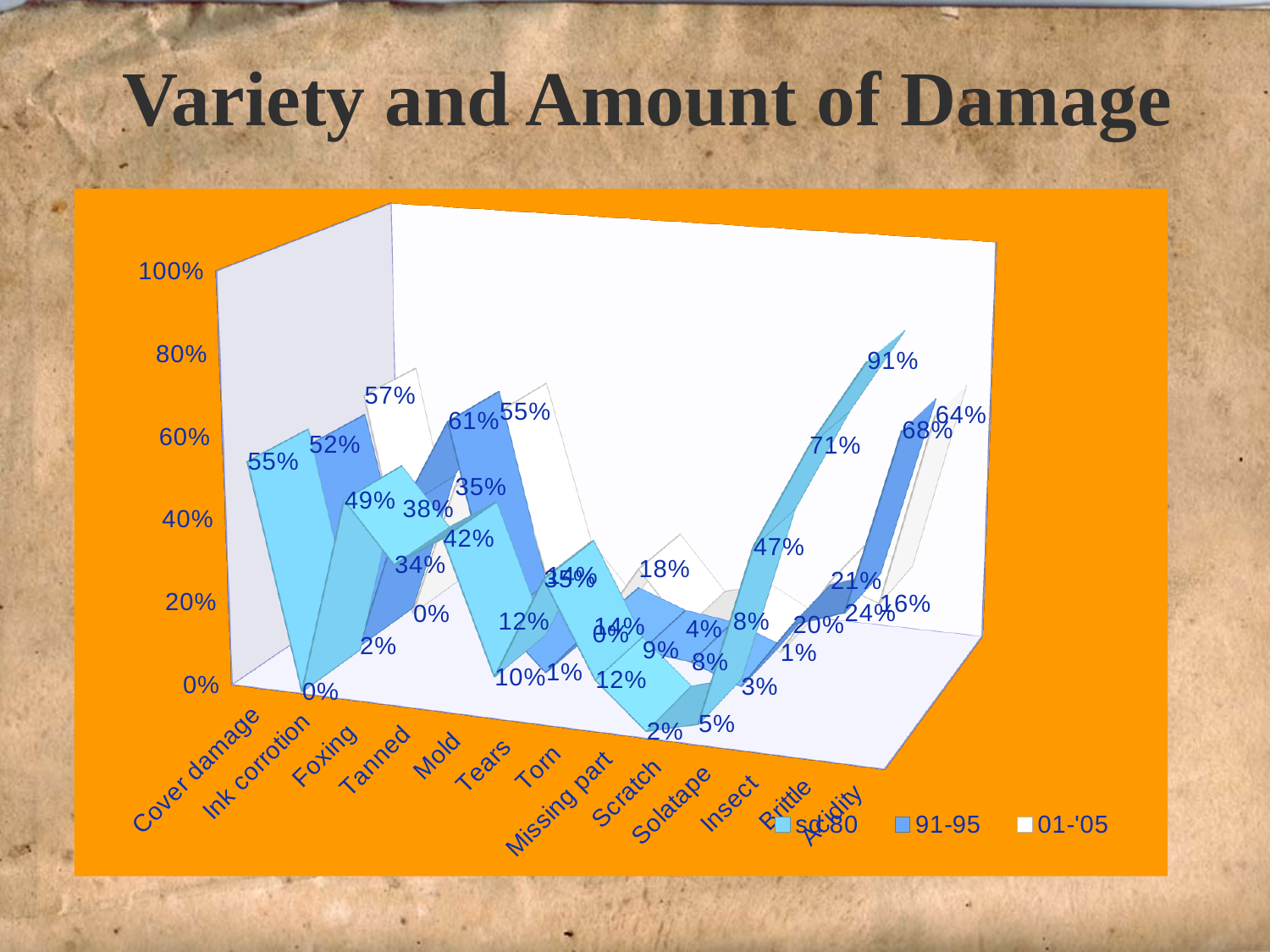
How many damage categories are shown along the x axis? 13 What is the highest data label value shown on the chart? 91% What is the last entry in the chart legend? 01-'05 For Cover damage, which series has the larger value, '80 or 91-95? '80 What is the value for Cover damage in the '80 series? 55% What is the difference between the 01-'05 and 91-95 values for Cover damage? 5% How many series does the legend list? 3 What is the title of the chart? Variety and Amount of Damage What is the maximum value shown on the vertical axis? 100% What is the value for Cover damage in the 91-95 series? 52% What is the value for Cover damage in the 01-'05 series? 57% What kind of chart is shown on the slide? line chart